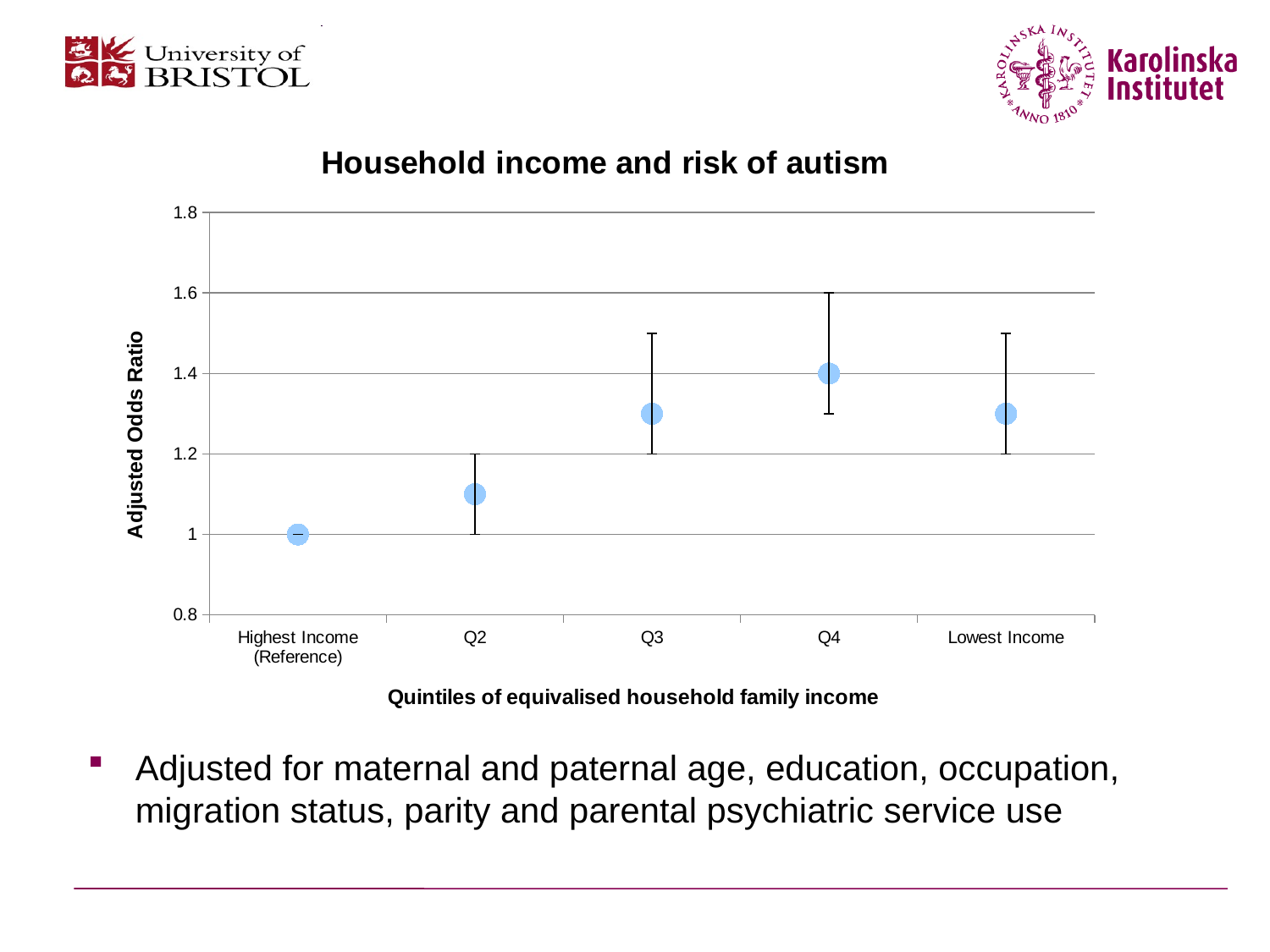
What is the adjusted odds ratio for Q4? 1.4 Which income quintile has the lowest adjusted odds ratio? Highest Income (Reference) How many income quintiles are plotted on the x axis? 5 What kind of chart is shown? Scatter chart with error bars What is the adjusted odds ratio for the Highest Income (Reference) quintile? 1 What is the difference between the adjusted odds ratio for Q4 and for Highest Income (Reference)? 0.4 Is the adjusted odds ratio for Lowest Income greater or less than 1.2? greater Do the adjusted odds ratios rise or fall from Highest Income (Reference) to Q4? rise Which has a larger adjusted odds ratio, Q2 or Q4? Q4 What is the title of the chart? Household income and risk of autism Is the adjusted odds ratio for Q2 greater or less than 1.2? less Which income quintile has the highest adjusted odds ratio? Q4